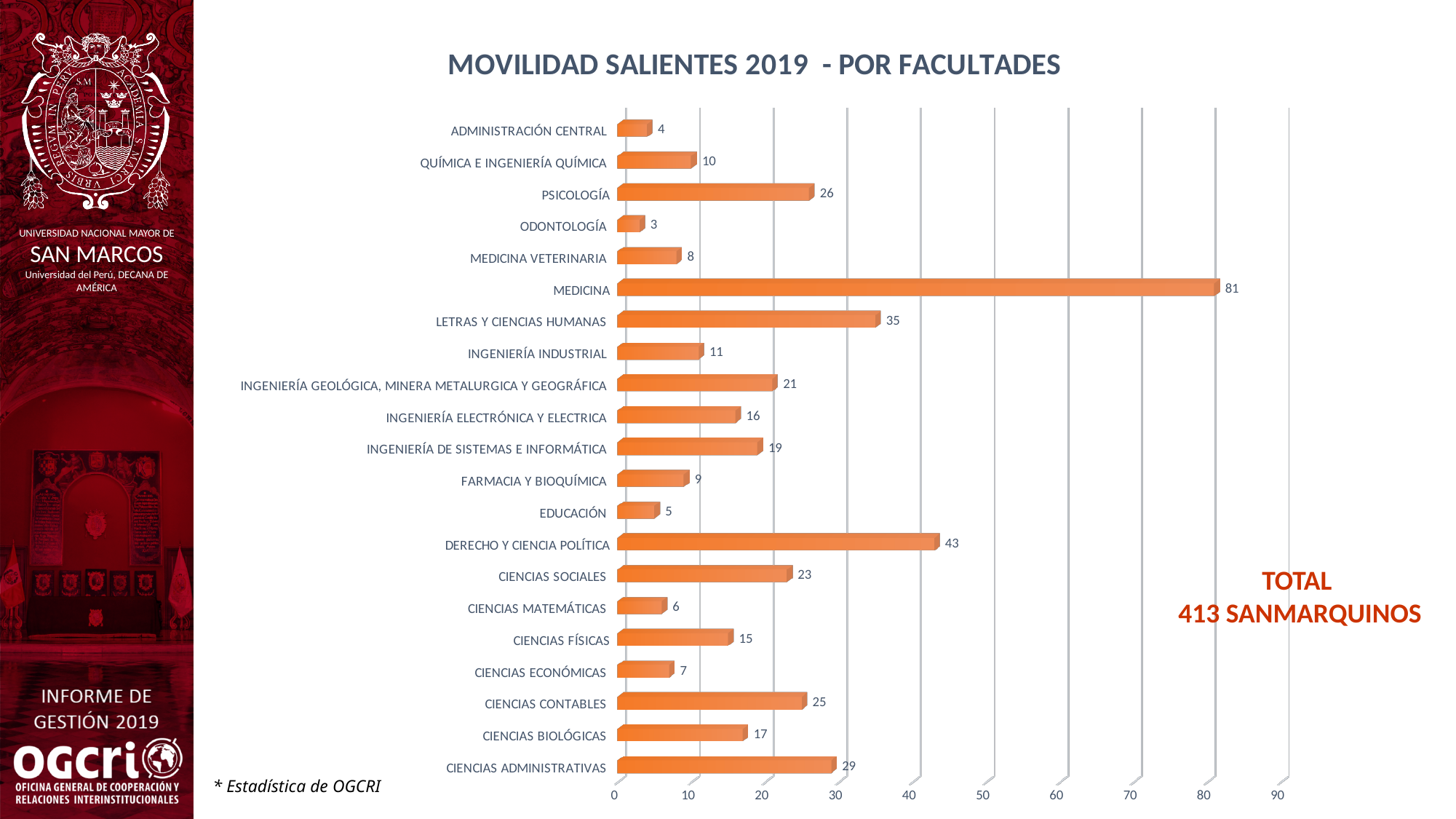
What kind of chart is shown on the slide? bar chart What is the value for DERECHO Y CIENCIA POLÍTICA? 43 What is the title of the chart? MOVILIDAD SALIENTES 2019 - POR FACULTADES Which faculty has the highest value? MEDICINA How many faculties are shown in the chart? 21 Which is larger, the value for PSICOLOGÍA or the value for CIENCIAS CONTABLES? PSICOLOGÍA Is the value for LETRAS Y CIENCIAS HUMANAS greater or less than 30? greater What total is stated next to the chart? 413 SANMARQUINOS What is the value for INGENIERÍA DE SISTEMAS E INFORMÁTICA? 19 Which faculty has the lowest value? ODONTOLOGÍA What is the value for MEDICINA? 81 What is the difference between the values for MEDICINA and DERECHO Y CIENCIA POLÍTICA? 38